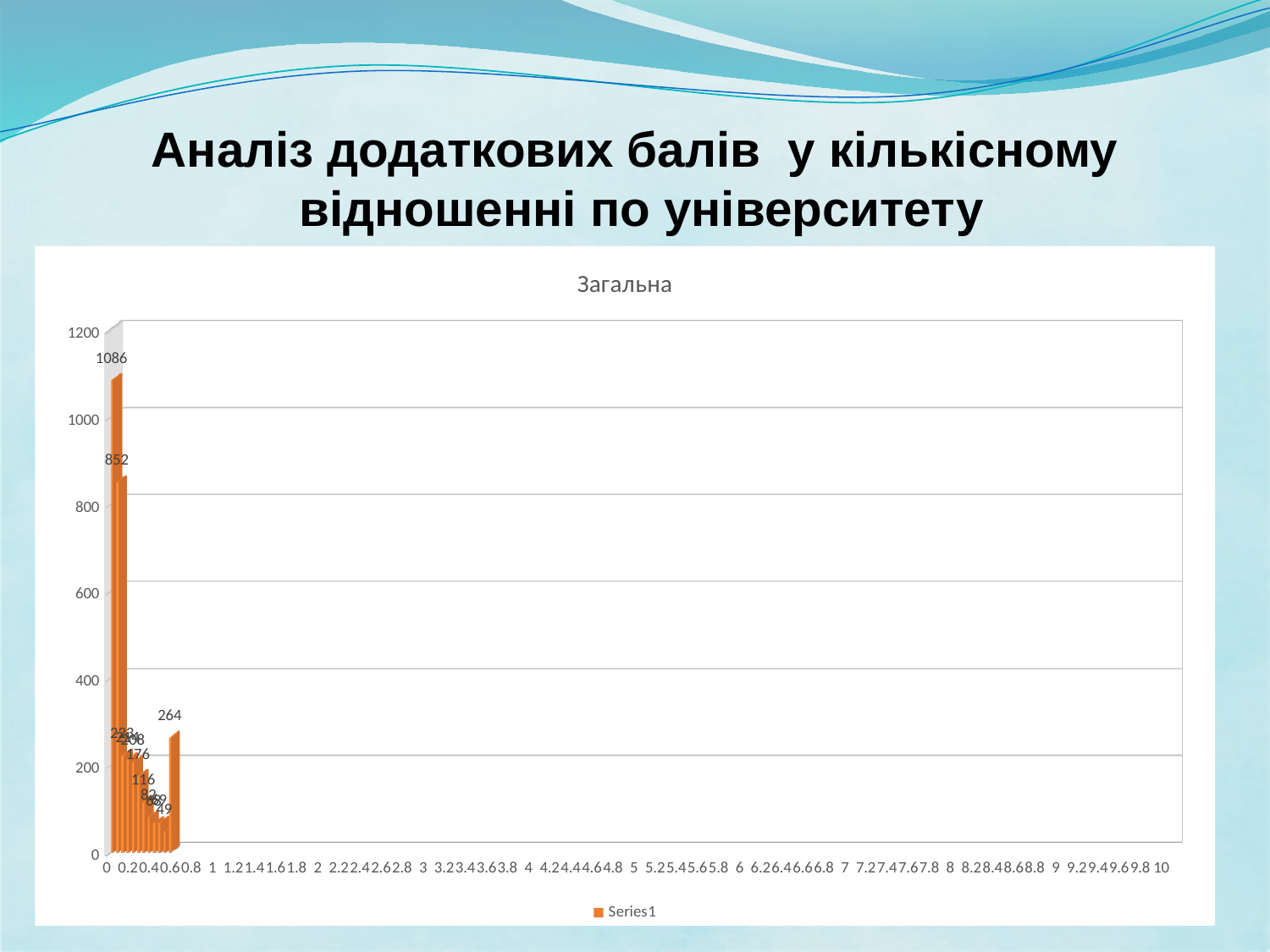
What is the difference between the bars labelled 264 and 176? 88 What is the value of the tallest bar in the chart? 1086 What is the highest value shown on the vertical axis? 1200 Is the bar labelled 264 greater or less than 400? less What is the title of the chart? Загальна What is the difference between the two tallest bars, labelled 1086 and 852? 234 Which is larger, the bar labelled 1086 or the bar labelled 852? 1086 What is the name of the series shown in the legend? Series1 What kind of chart is shown on the slide? bar chart Is the value of the tallest bar greater or less than 1000? greater How many series does the legend list? 1 What is the value of the second tallest bar in the chart? 852